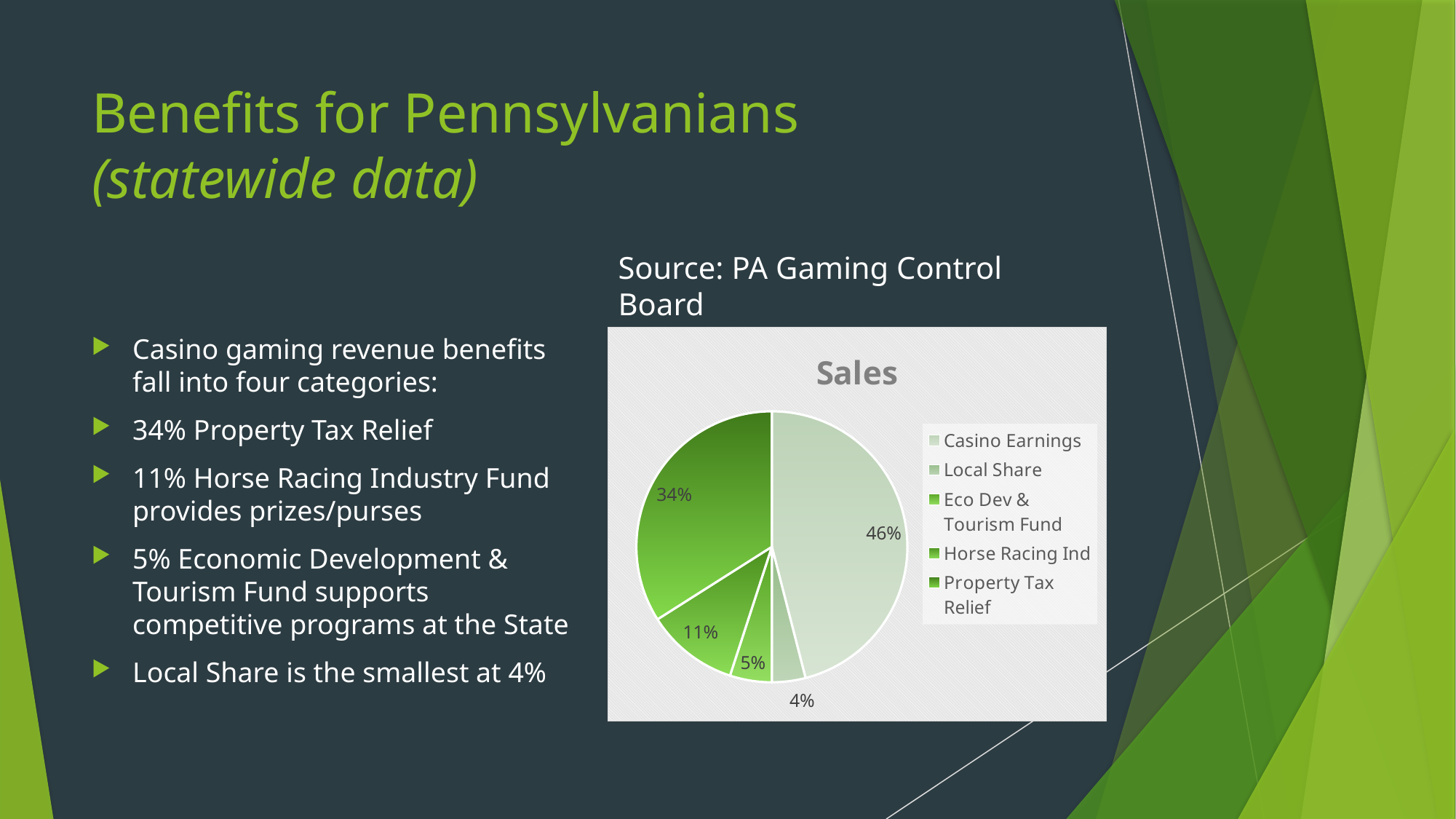
What share of the pie is Eco Dev & Tourism Fund? 5% Which slice of the pie is the smallest? Local Share What type of chart is shown on the slide? pie chart What share of the pie is Property Tax Relief? 34% What share of the pie is Horse Racing Ind? 11% What is the difference in percentage points between Casino Earnings and Property Tax Relief? 12 How many slices does the pie chart have? 5 What share of the pie is Casino Earnings? 46% What share of the pie is Local Share? 4% Which slice of the pie is the largest? Casino Earnings What is the title of the chart? Sales Which is larger, Horse Racing Ind or Eco Dev & Tourism Fund? Horse Racing Ind